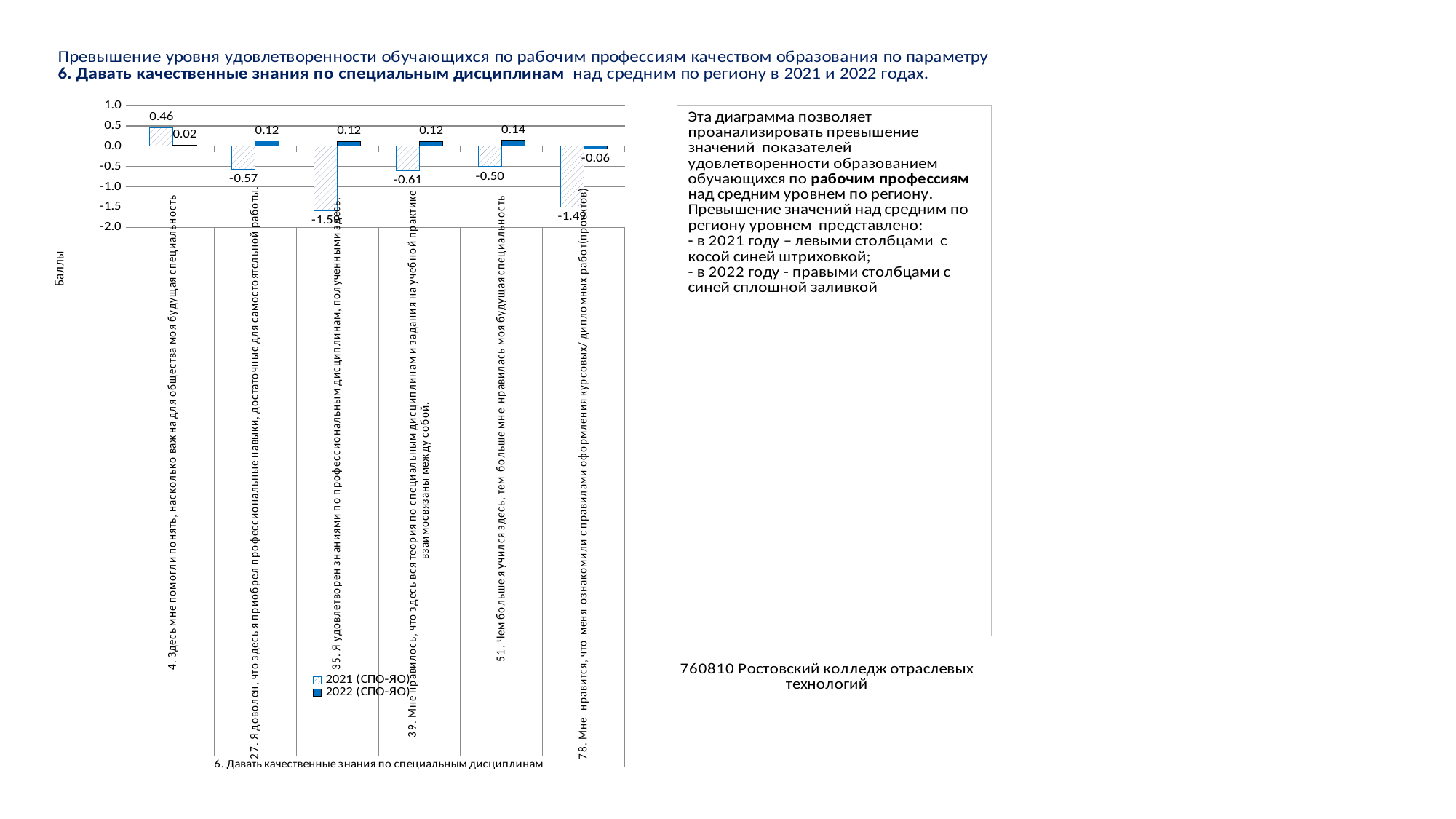
What is the 2021 (СПО-ЯО) value for category 4 (Здесь мне помогли понять, насколько важна для общества моя будущая специальность)? 0.46 What is the 2022 (СПО-ЯО) value for category 78 (Мне нравится, что меня ознакомили с правилами оформления курсовых/дипломных работ)? -0.06 How many series does the chart legend list? 2 Is the 2021 (СПО-ЯО) value for category 35 greater or less than -1.0? less Which category has the highest 2021 (СПО-ЯО) value? 4. Здесь мне помогли понять, насколько важна для общества моя будущая специальность What is the 2021 (СПО-ЯО) value for category 39 (Мне нравилось, что здесь вся теория по специальным дисциплинам и задания на учебной практике взаимосвязаны между собой)? -0.61 For category 27, which series has the larger value, 2021 (СПО-ЯО) or 2022 (СПО-ЯО)? 2022 (СПО-ЯО) Which category has the lowest 2022 (СПО-ЯО) value? 78. Мне нравится, что меня ознакомили с правилами оформления курсовых/дипломных работ What is the difference between the 2021 and 2022 values for category 4? 0.44 What kind of chart is shown on the slide? bar chart How many categories are shown on the x axis of the chart? 6 What is the 2022 (СПО-ЯО) value for category 51 (Чем больше я учился здесь, тем больше мне нравилась моя будущая специальность)? 0.14